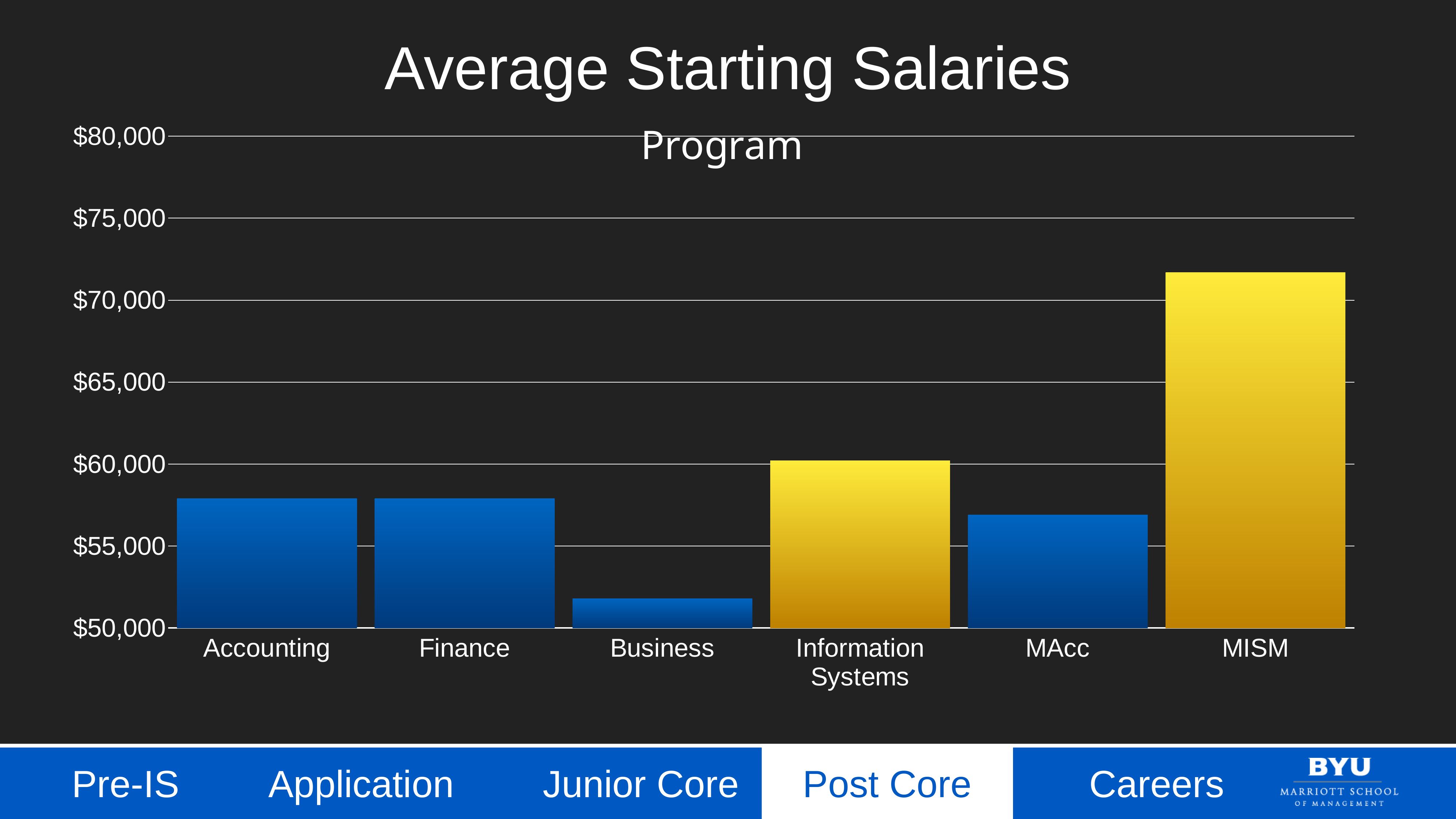
What is the title of the chart? Program How many programs are shown on the x axis of the chart? 6 Which is larger, the value for MISM or the value for Information Systems? MISM Is the value for Finance greater or less than $60,000? less Is the value for Information Systems greater or less than $65,000? less Which is larger, the value for Information Systems or the value for Accounting? Information Systems Is the value for MISM greater or less than $70,000? greater Which program has the highest average starting salary? MISM What kind of chart is shown on the slide? bar chart Which program has the lowest average starting salary? Business